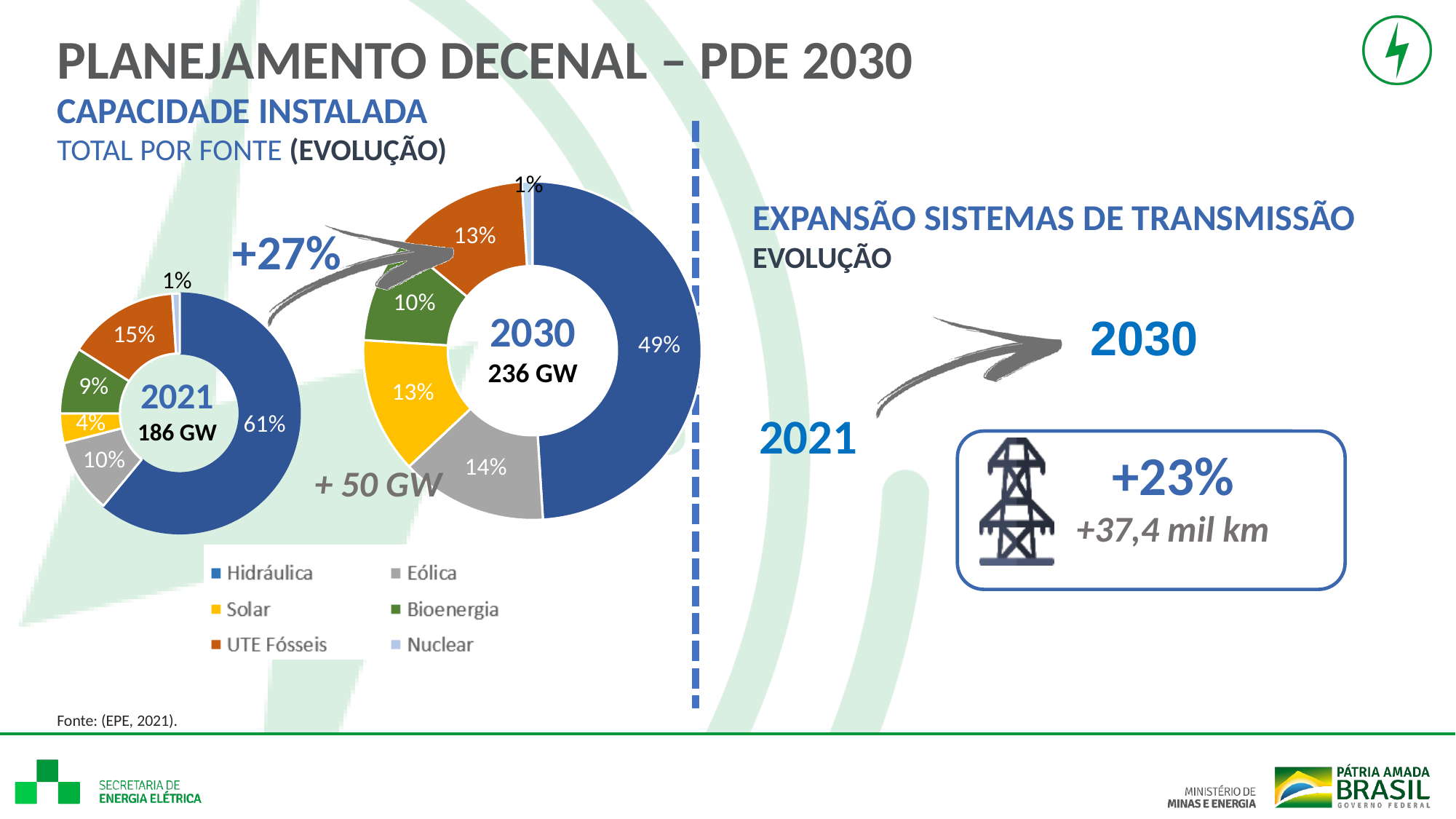
In the 2021 donut chart, what share does Solar have? 4% In the 2021 donut chart, what share does UTE Fósseis have? 15% In the 2030 donut chart, what share does Hidráulica have? 49% What is the difference between the Hidráulica share in 2021 and in 2030? 12 percentage points In the 2030 donut chart, which source has the largest share? Hidráulica In the 2021 donut chart, which source has the smallest share? Nuclear In the 2021 donut chart, what share does Hidráulica have? 61% Is the Solar share larger in the 2021 chart or the 2030 chart? 2030 What total installed capacity is shown in the centre of the 2030 donut chart? 236 GW In the 2030 donut chart, what share does Eólica have? 14% How many sources does the legend list for the donut charts? 6 What type of chart is used to show installed capacity by source? Donut (pie) chart